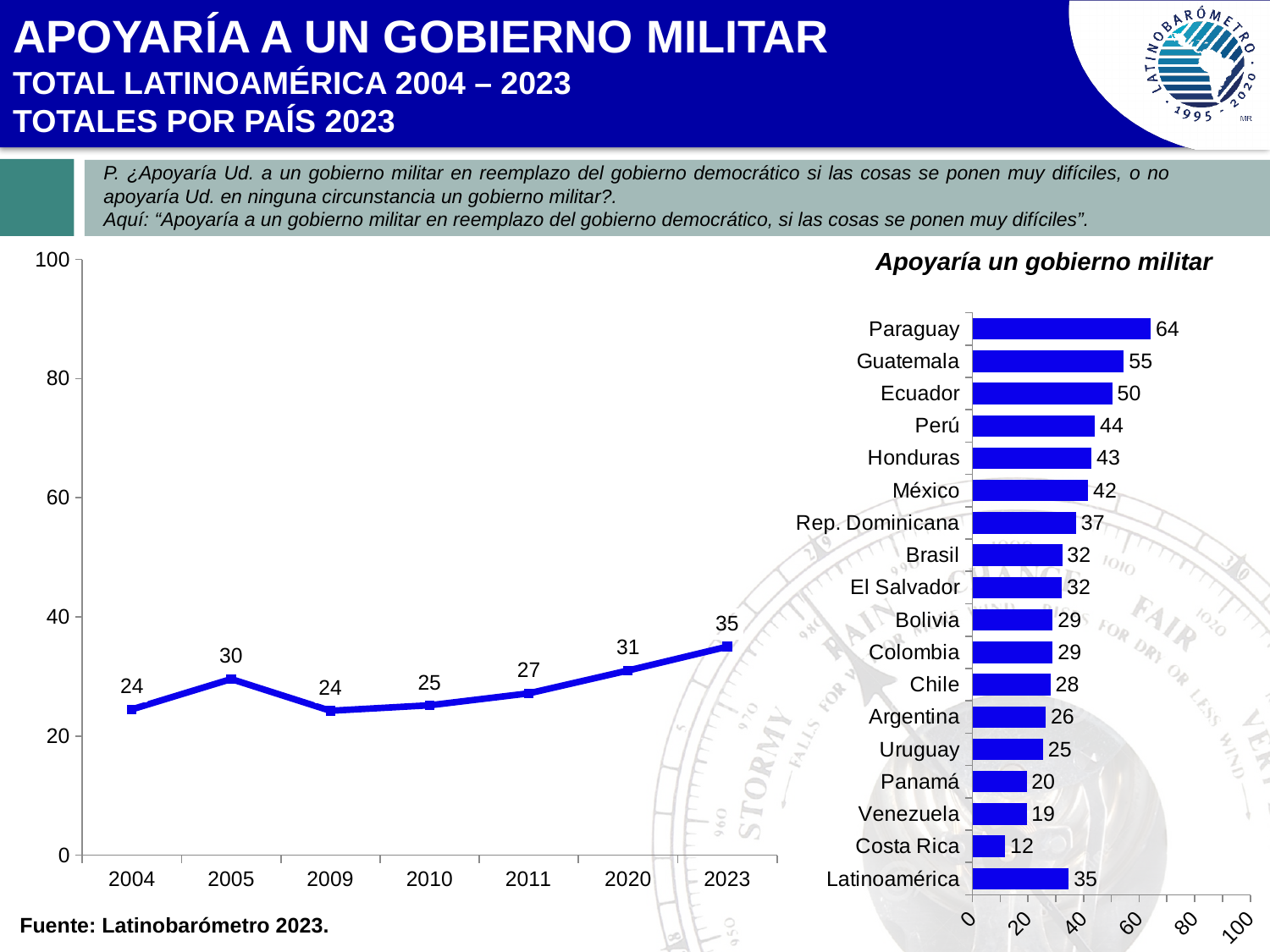
In the bar chart titled 'Apoyaría un gobierno militar', which country has the lowest value? Costa Rica What kind of chart is the chart on the right of the slide? bar chart In the line chart on the left, which year has the lowest value? 2004 and 2009 In the line chart on the left, what is the value for 2023? 35 In the bar chart titled 'Apoyaría un gobierno militar', what is the difference between Paraguay and Costa Rica? 52 In the line chart on the left, what is the value for 2005? 30 In the line chart on the left, what is the difference between the 2023 value and the 2004 value? 11 In the bar chart titled 'Apoyaría un gobierno militar', what is the value for Paraguay? 64 In the line chart on the left, how many years are plotted? 7 In the bar chart titled 'Apoyaría un gobierno militar', which is larger, Guatemala or Ecuador? Guatemala In the line chart on the left, do the values rise or fall from 2009 to 2023? rise In the bar chart titled 'Apoyaría un gobierno militar', what is the value for Latinoamérica? 35